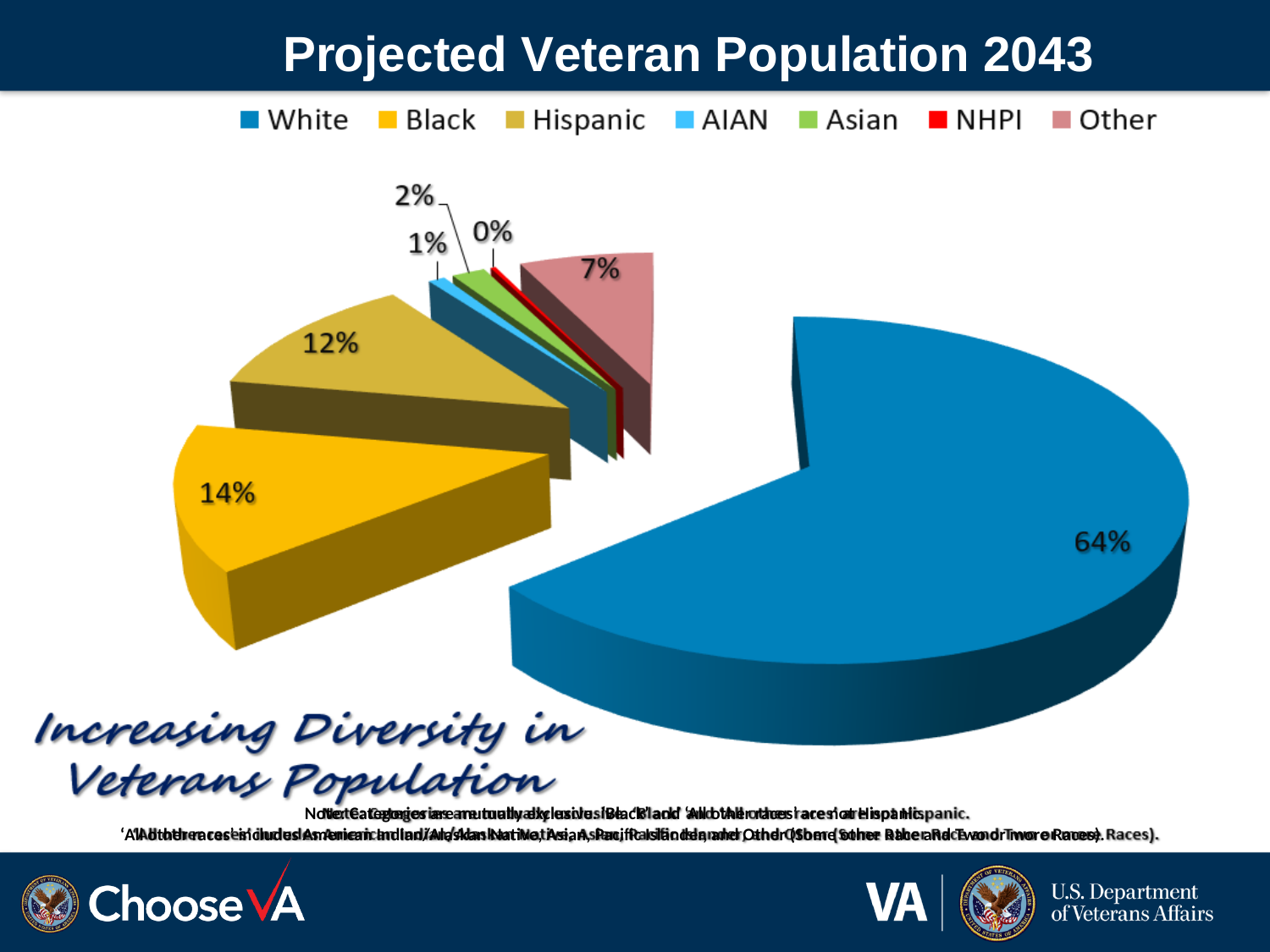
What is the title of the chart? Projected Veteran Population 2043 How many categories does the legend list? 7 What share of the projected 2043 veteran population is Other? 7% What share of the projected 2043 veteran population is NHPI? 0% Which category has the smallest share of the pie? NHPI Which is larger, the Other share or the Asian share? Other What kind of chart is shown on the slide? Pie chart What is the difference in percentage points between the Black and Hispanic shares? 2 percentage points What share of the projected 2043 veteran population is Black? 14% What share of the projected 2043 veteran population is Hispanic? 12% Which category has the largest share of the pie? White What share of the projected 2043 veteran population is White? 64%